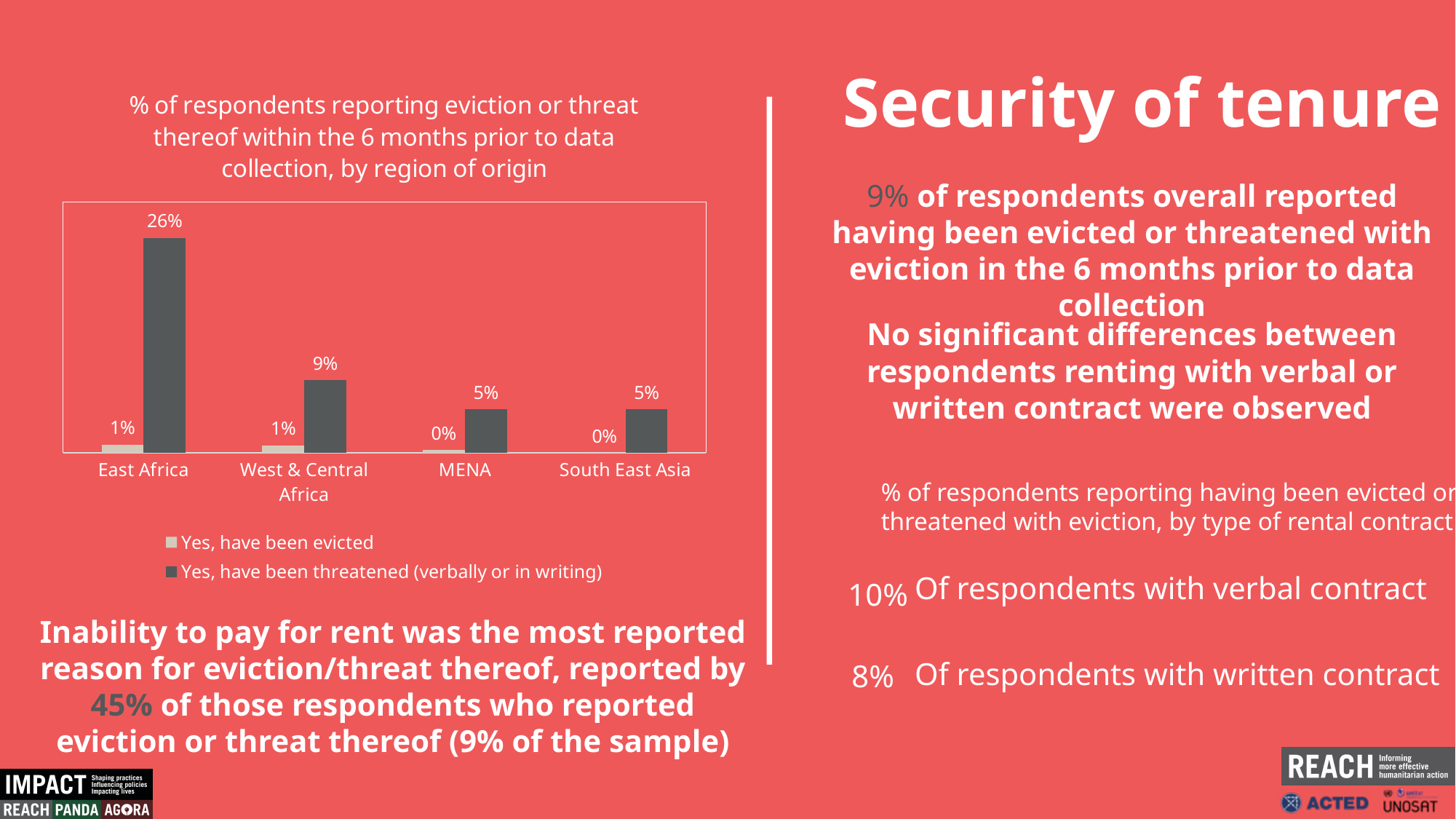
What percentage of respondents from South East Asia reported having been evicted? 0% What is the total of the two values shown for East Africa? 27% What percentage of respondents from West & Central Africa reported having been evicted? 1% How many series does the chart's legend list? 2 Which region of origin has the highest percentage of respondents reporting having been threatened with eviction? East Africa Which legend entry is represented by the dark grey bars? Yes, have been threatened (verbally or in writing) Which is larger: the percentage of respondents threatened with eviction in West & Central Africa or in MENA? West & Central Africa How many regions of origin are shown on the x axis of the chart? 4 What percentage of respondents from East Africa reported having been threatened with eviction (verbally or in writing)? 26% What type of chart is used to show eviction or threat thereof by region of origin? Bar chart What is the difference between the percentage of East Africa respondents threatened with eviction and the percentage of West & Central Africa respondents threatened with eviction? 17% What percentage of respondents from MENA reported having been threatened with eviction? 5%